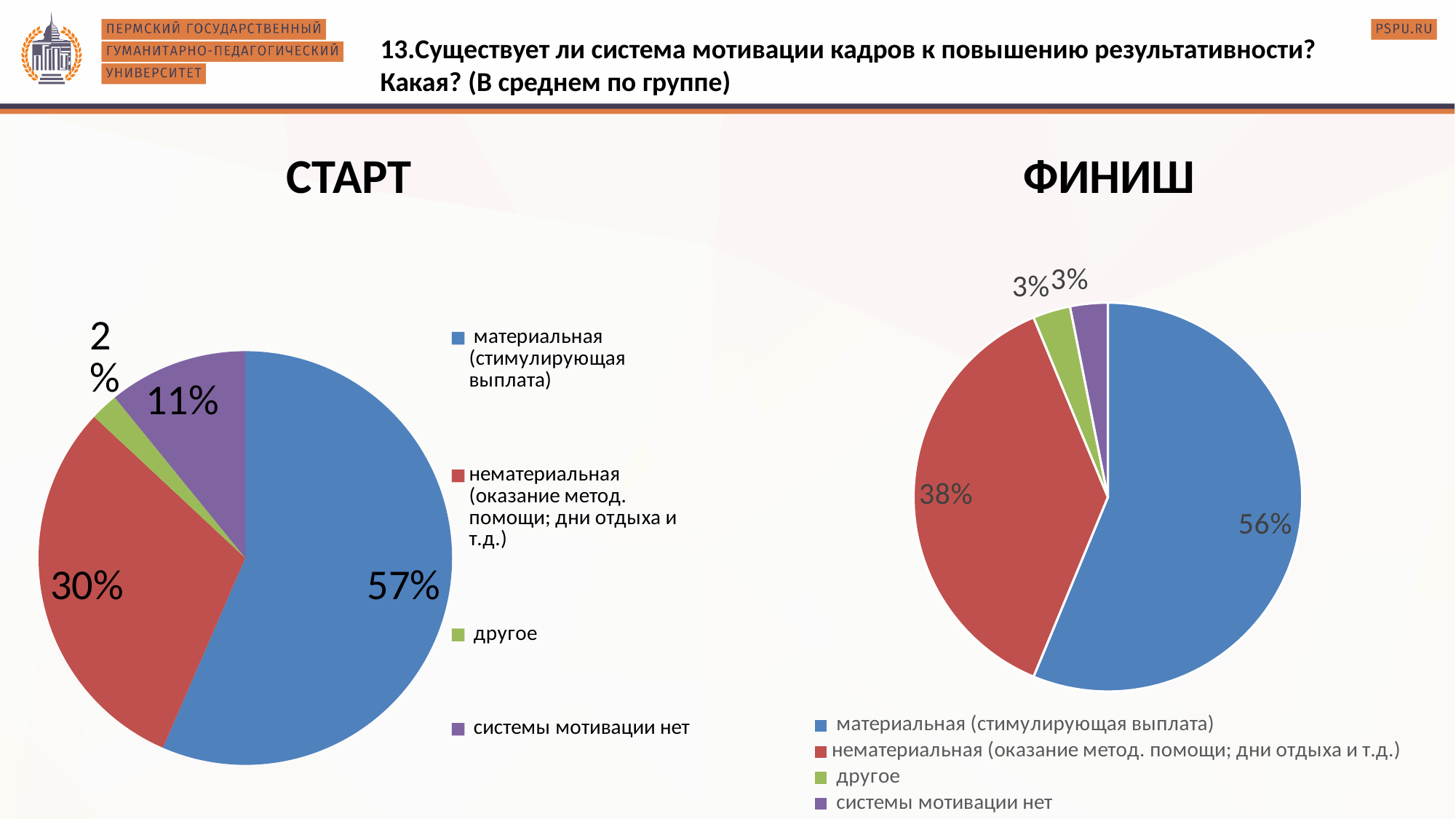
In the СТАРТ pie chart, which category has the largest slice? материальная (стимулирующая выплата) In the СТАРТ pie chart, what is the difference between the материальная and нематериальная shares? 27% How many categories does the legend of the ФИНИШ chart list? 4 In the ФИНИШ pie chart, what share is labelled for материальная (стимулирующая выплата)? 56% In the ФИНИШ pie chart, what share is labelled for нематериальная (оказание метод. помощи; дни отдыха и т.д.)? 38% What type of chart is used for СТАРТ and ФИНИШ? Pie chart In the СТАРТ pie chart, what share is labelled for нематериальная (оказание метод. помощи; дни отдыха и т.д.)? 30% In the СТАРТ pie chart, what share is labelled for системы мотивации нет? 11% In the СТАРТ pie chart, which category has the smallest slice? другое In the ФИНИШ pie chart, what share is labelled for другое? 3% In the ФИНИШ pie chart, which is larger: the share for материальная or the share for нематериальная? материальная (стимулирующая выплата) In the СТАРТ pie chart, what share is labelled for материальная (стимулирующая выплата)? 57%